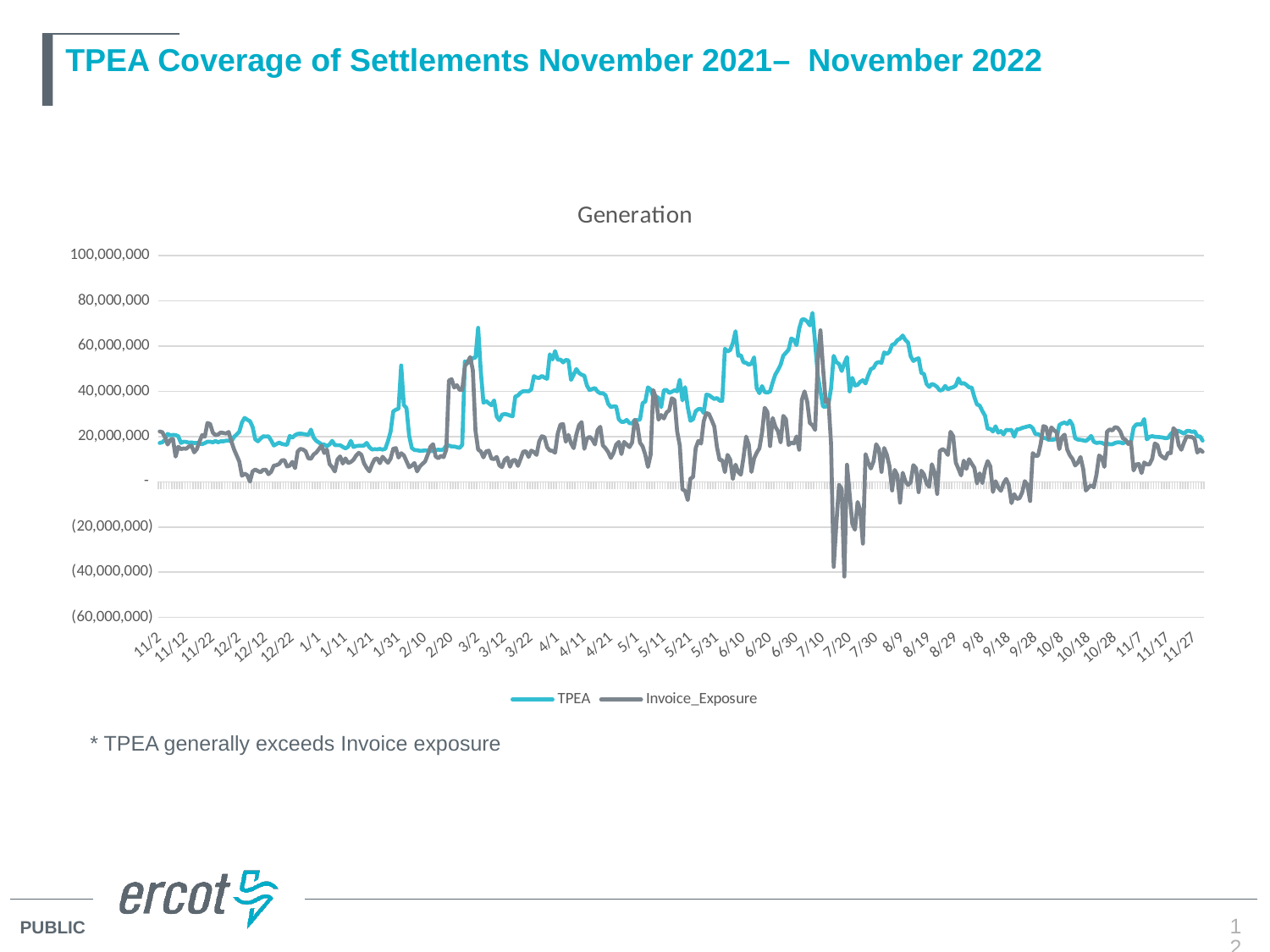
What is the title of the chart? Generation What is the highest value shown on the vertical axis of the chart? 100,000,000 Around 12/2, is the value for TPEA greater or less than 40,000,000? less Which series drops to the lowest value on the chart, TPEA or Invoice_Exposure? Invoice_Exposure Which two series are listed in the chart legend? TPEA and Invoice_Exposure Around 7/20, is the value for Invoice_Exposure greater or less than 0? less Is the lowest value reached by the Invoice_Exposure series greater or less than (20,000,000)? less How many series does the legend of the chart list? 2 What kind of chart is shown on the slide? line chart Around 7/20, which series has the larger value, TPEA or Invoice_Exposure? TPEA